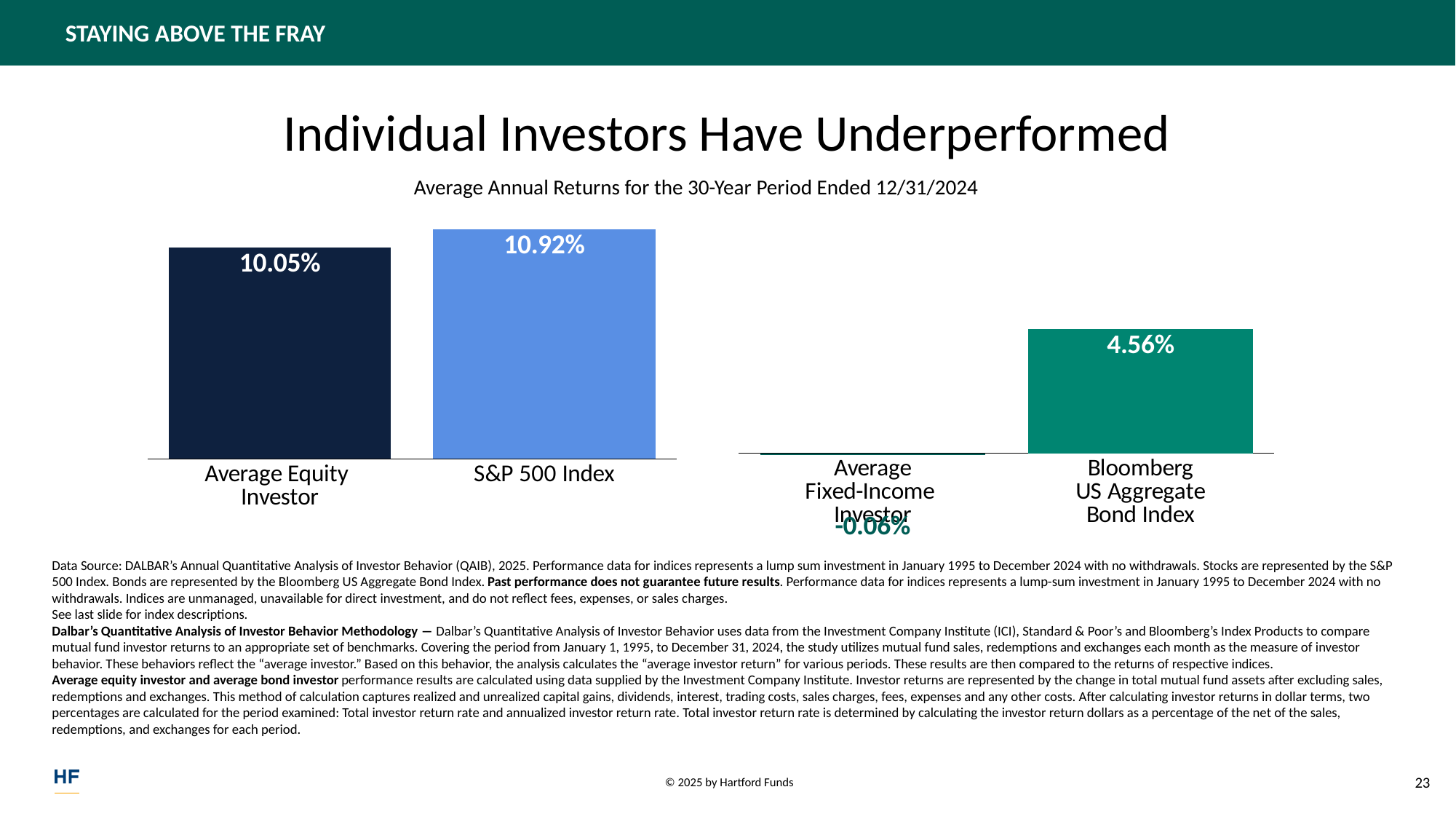
In the left chart, what is the average annual return for the Average Equity Investor? 10.05% In the right chart, which category has the highest value? Bloomberg US Aggregate Bond Index In the right chart, which category has the lowest value? Average Fixed-Income Investor In the left chart, what is the average annual return for the S&P 500 Index? 10.92% In the right chart, what is the average annual return for the Bloomberg US Aggregate Bond Index? 4.56% What type of chart is used on this slide? Bar chart What is the subtitle describing the period covered by the charts? Average Annual Returns for the 30-Year Period Ended 12/31/2024 In the right chart, what is the difference between the Bloomberg US Aggregate Bond Index return and the Average Fixed-Income Investor return? 4.62% How many bars are shown in the left chart? 2 In the left chart, what is the difference between the S&P 500 Index return and the Average Equity Investor return? 0.87% In the right chart, what is the average annual return for the Average Fixed-Income Investor? -0.06% In the left chart, which bar is higher: Average Equity Investor or S&P 500 Index? S&P 500 Index